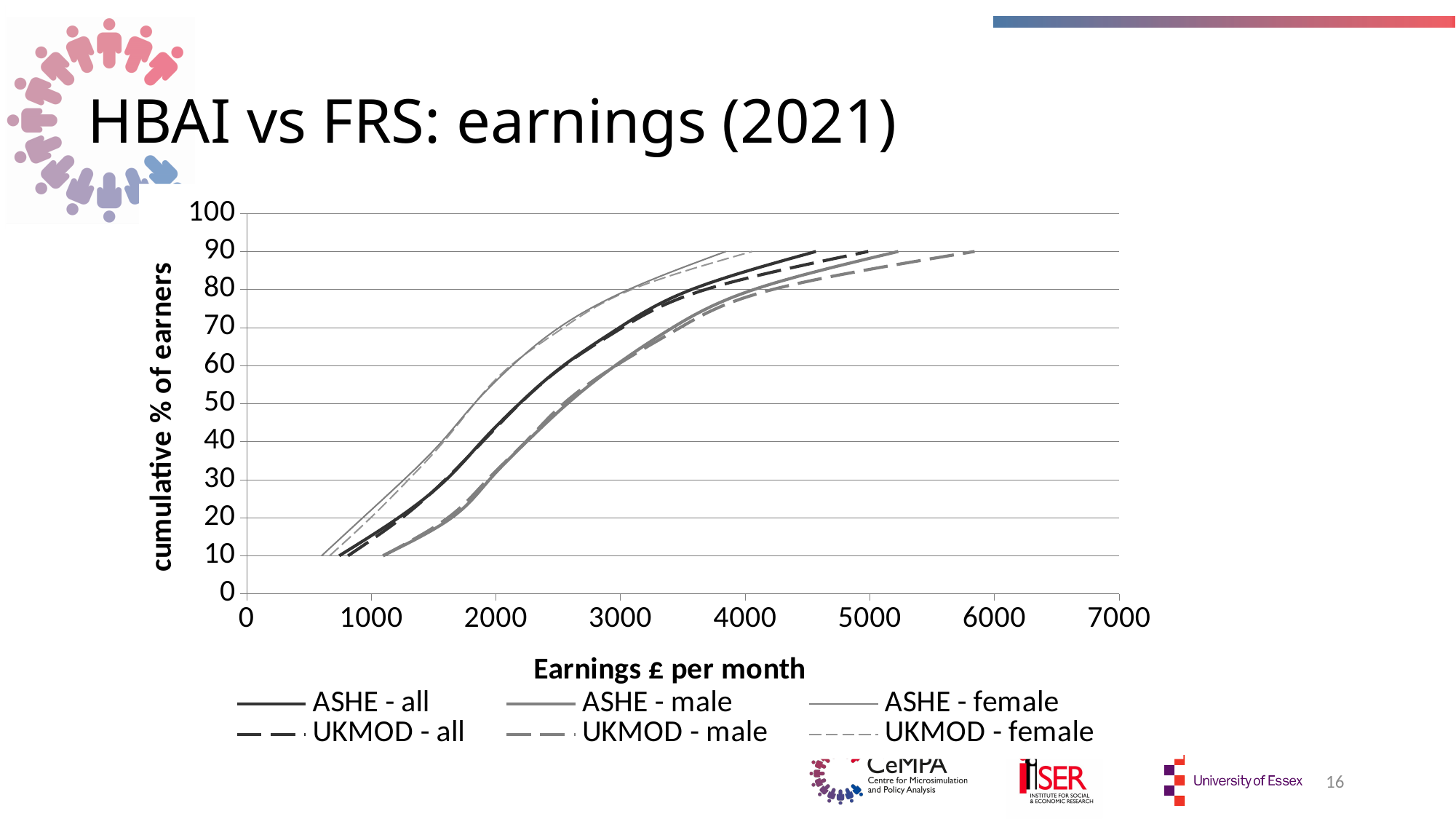
What kind of chart is shown on the slide? line chart At earnings of 2000 £ per month, is the value for ASHE - male greater or less than 40? less At earnings of 3000 £ per month, which is higher: ASHE - female or ASHE - male? ASHE - female Which series reaches 90% of earners at the highest earnings level? UKMOD - male How many series does the legend list? 6 What is the label of the x axis? Earnings £ per month What is the title of the chart? HBAI vs FRS: earnings (2021) At earnings of 4000 £ per month, is the value for ASHE - all greater or less than 80? greater Do the plotted lines rise or fall as earnings per month increase? rise At earnings of 3000 £ per month, is the value for ASHE - male greater or less than 70? less